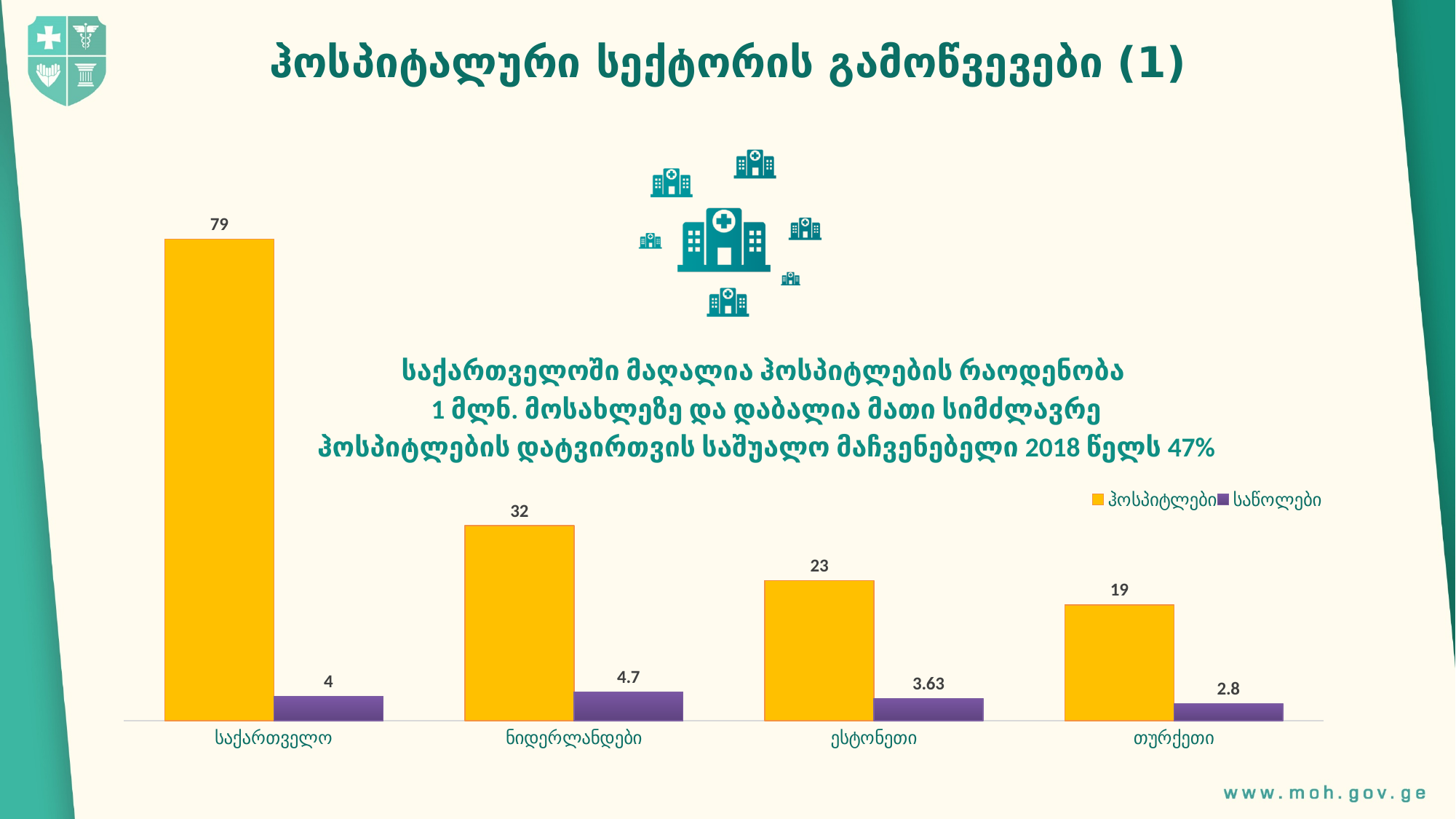
What kind of chart is shown on the slide? bar chart How many series does the legend list? 2 What is the value of საწოლები for ესტონეთი? 3.63 What is the value of საწოლები for ნიდერლანდები? 4.7 How many categories are shown on the x axis? 4 What is the difference between the ჰოსპიტლები values for საქართველო and ნიდერლანდები? 47 Do the ჰოსპიტლები values rise or fall from left to right along the x axis? fall Which is larger, the საწოლები value for საქართველო or for ნიდერლანდები? ნიდერლანდები Which category has the highest ჰოსპიტლები value? საქართველო Which category has the lowest საწოლები value? თურქეთი What is the value of ჰოსპიტლები for თურქეთი? 19 What is the value of ჰოსპიტლები for საქართველო? 79